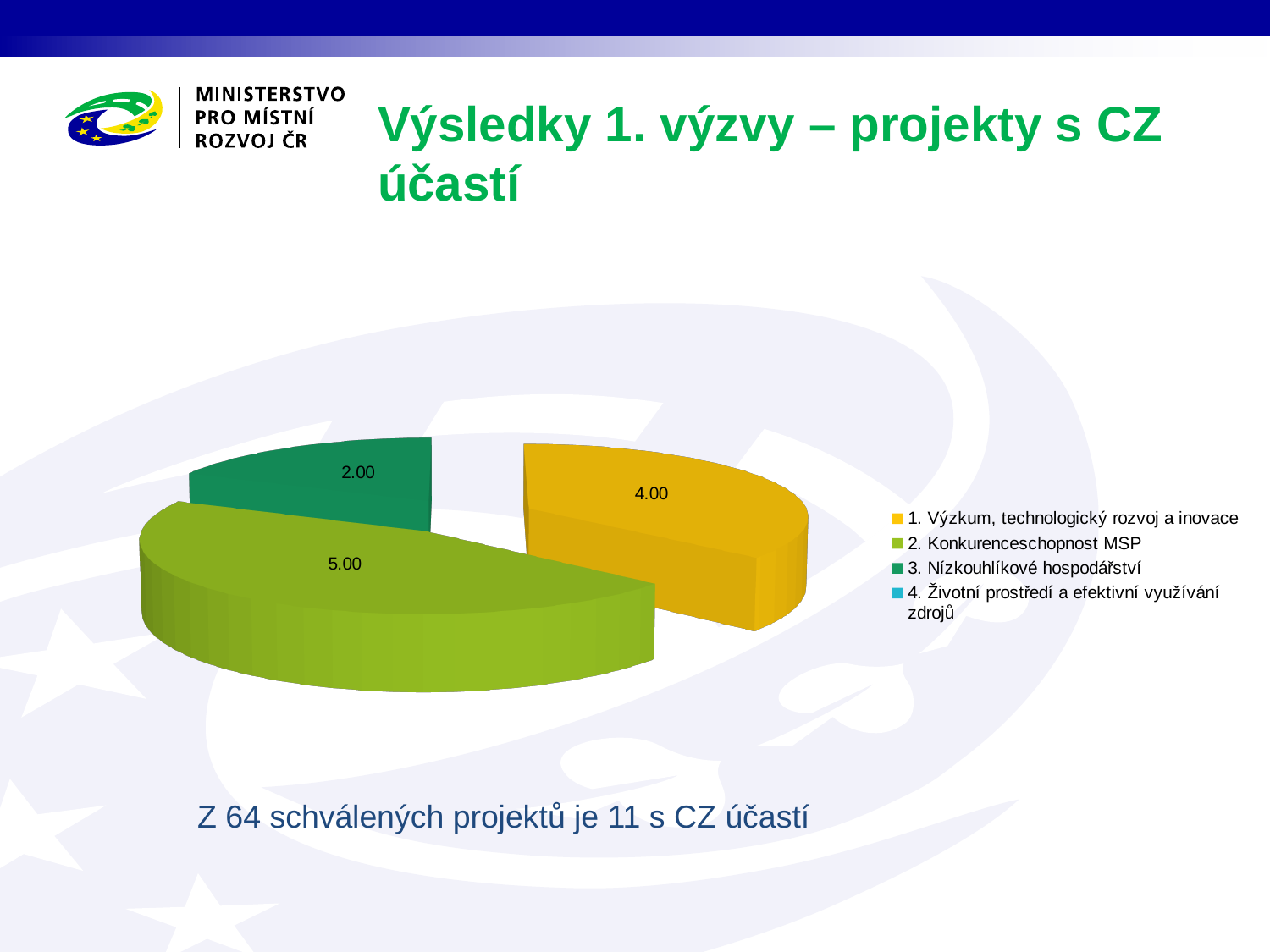
How many entries does the legend of the pie chart list? 4 What is the difference between the values for '2. Konkurenceschopnost MSP' and '1. Výzkum, technologický rozvoj a inovace'? 1.00 What is the difference between the values for '2. Konkurenceschopnost MSP' and '3. Nízkouhlíkové hospodářství'? 3.00 Which category with a visible slice has the smallest value? 3. Nízkouhlíkové hospodářství What is the value of the slice for '3. Nízkouhlíkové hospodářství'? 2.00 What type of chart is shown on the slide? pie chart Which is larger: the slice for '1. Výzkum, technologický rozvoj a inovace' or the slice for '3. Nízkouhlíkové hospodářství'? 1. Výzkum, technologický rozvoj a inovace What colour is the slice for '1. Výzkum, technologický rozvoj a inovace'? yellow What is the total of the three labelled slices in the pie chart? 11.00 What is the value of the slice for '1. Výzkum, technologický rozvoj a inovace'? 4.00 What is the value of the slice for '2. Konkurenceschopnost MSP'? 5.00 Which category has the largest slice in the pie chart? 2. Konkurenceschopnost MSP